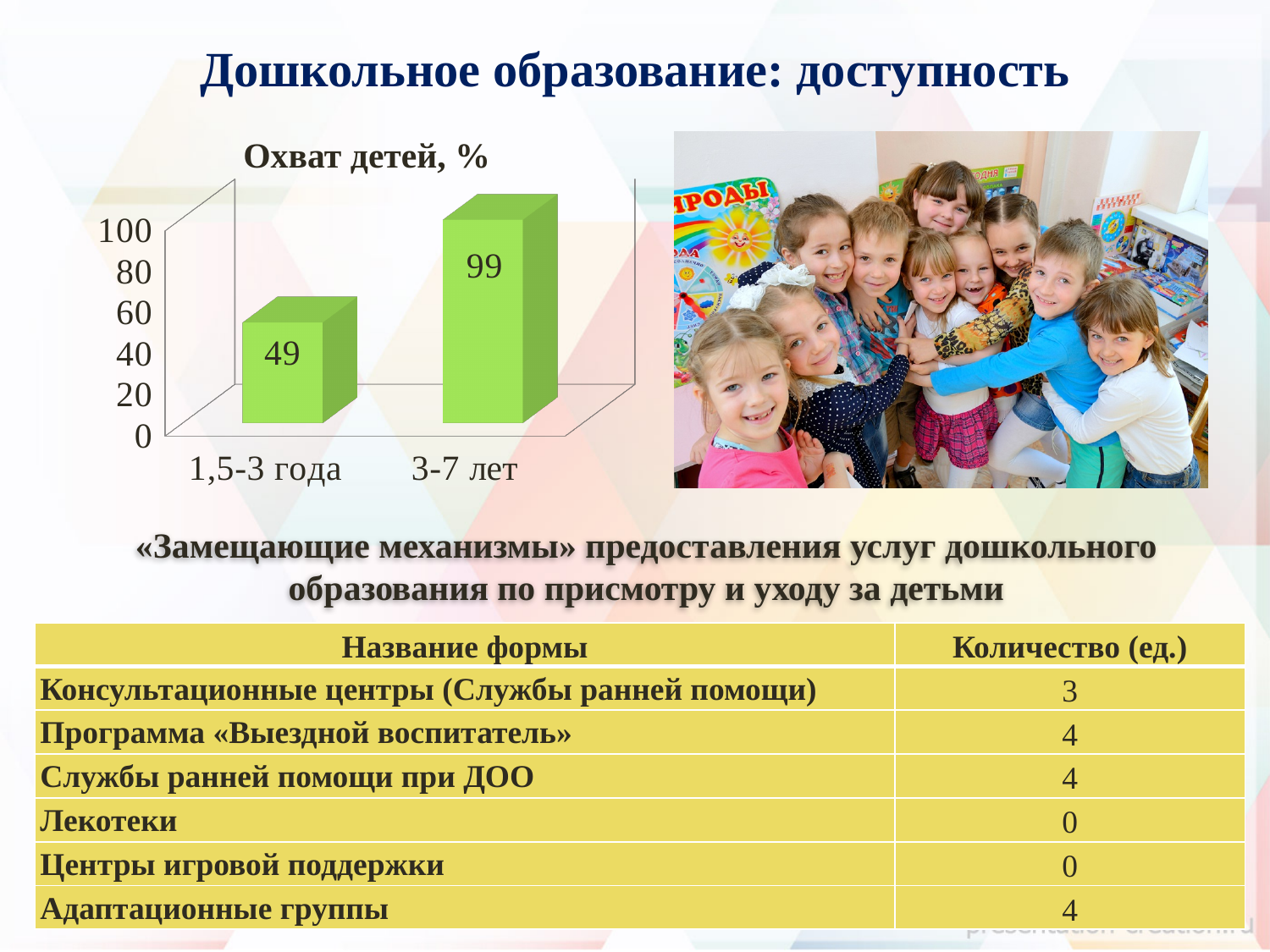
Do the values rise or fall from left to right in the Охват детей, % chart? rise What is the title of the chart on the slide? Охват детей, % Which is larger in the Охват детей, % chart: the value for 1,5-3 года or for 3-7 лет? 3-7 лет What is the value for the 1,5-3 года category in the Охват детей, % chart? 49 Is the value for 3-7 лет in the Охват детей, % chart greater or less than 80? greater How many categories are shown in the Охват детей, % chart? 2 What is the value for the 3-7 лет category in the Охват детей, % chart? 99 What kind of chart is the Охват детей, % chart? bar chart Is the value for 1,5-3 года in the Охват детей, % chart greater or less than 60? less What is the difference between the values for 3-7 лет and 1,5-3 года in the Охват детей, % chart? 50 Which category has the lowest value in the Охват детей, % chart? 1,5-3 года Which category has the highest value in the Охват детей, % chart? 3-7 лет